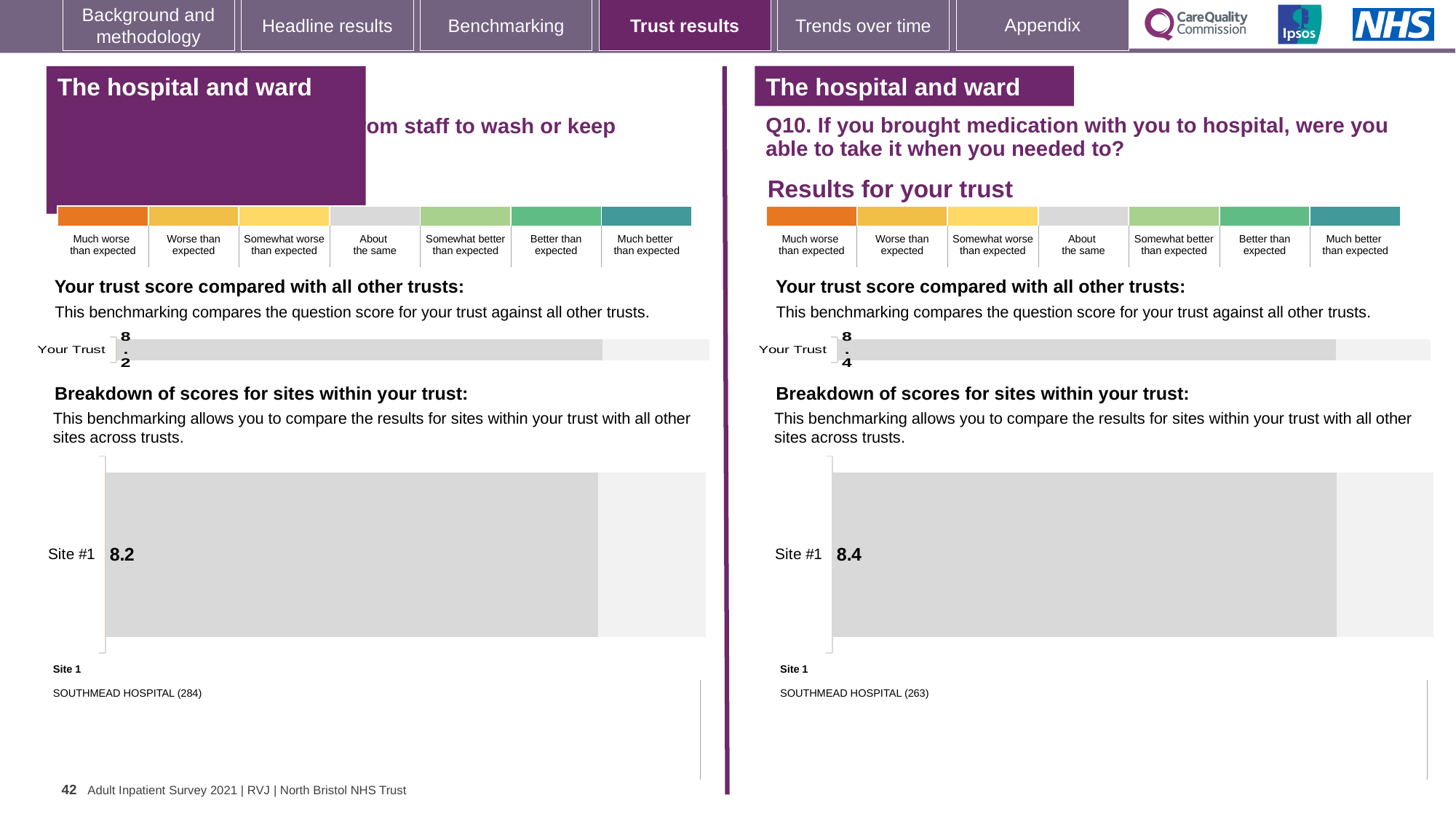
On the right-hand side of the slide (Q10, medication), what is the score shown for Your Trust? 8.4 In the right-hand 'Breakdown of scores for sites within your trust' chart (Q10), what is the score for Site #1? 8.4 How many sites are shown in the left-hand 'Breakdown of scores for sites within your trust' chart? 1 Is the Site #1 score on the right-hand side of the slide (Q10) the same as the Your Trust score on that side? Yes, both are 8.4 Which hospital is listed as Site 1 on the left-hand side of the slide? SOUTHMEAD HOSPITAL (284) On the left-hand side of the slide, what is the score shown for Your Trust? 8.2 In the left-hand 'Breakdown of scores for sites within your trust' chart, what is the score for Site #1? 8.2 Which is larger: the Your Trust score on the left-hand side of the slide or the Your Trust score on the right-hand side (Q10)? Right-hand side (Q10), 8.4 Which hospital is listed as Site 1 on the right-hand side of the slide (Q10)? SOUTHMEAD HOSPITAL (263) What type of chart is used to show the Site #1 score on the right-hand side of the slide (Q10)? Bar chart How many sites are shown in the right-hand 'Breakdown of scores for sites within your trust' chart (Q10)? 1 What is the difference between the Site #1 score on the right-hand side (Q10) and the Site #1 score on the left-hand side? 0.2